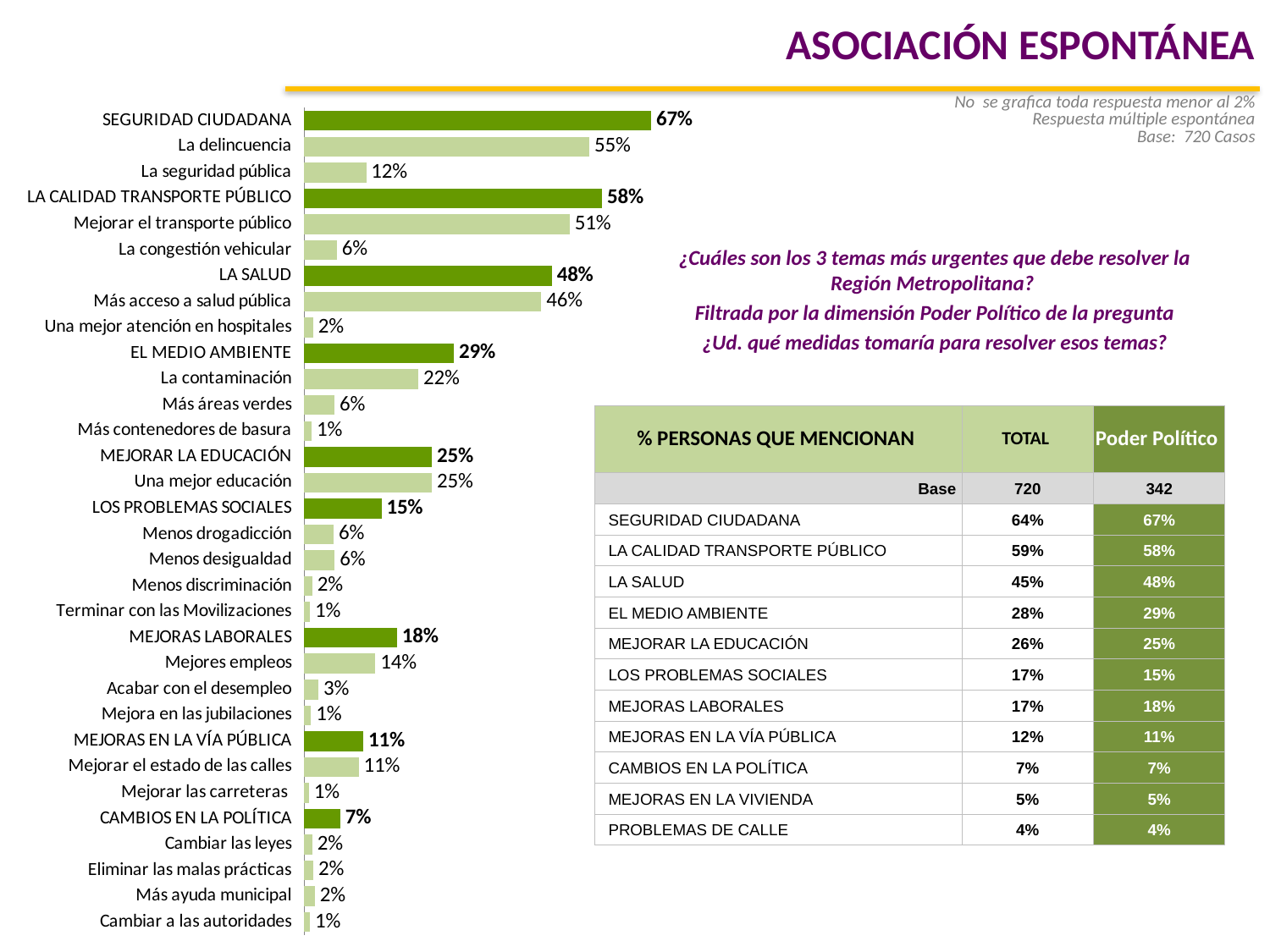
What kind of chart is shown on the slide? bar chart What is the difference between the values for LA CALIDAD TRANSPORTE PÚBLICO and LA SALUD in the bar chart? 10% What is the difference between the values for EL MEDIO AMBIENTE and La contaminación in the bar chart? 7% What is the value for Mejores empleos in the bar chart? 14% What is the value for Más acceso a salud pública in the bar chart? 46% What is the value for SEGURIDAD CIUDADANA in the bar chart? 67% What is the value for La delincuencia in the bar chart? 55% How many categories are plotted in the bar chart? 32 What is the value for CAMBIOS EN LA POLÍTICA in the bar chart? 7% Which is larger in the bar chart, La seguridad pública or La congestión vehicular? La seguridad pública Which is larger in the bar chart, MEJORAS LABORALES or LOS PROBLEMAS SOCIALES? MEJORAS LABORALES Which category has the highest value in the bar chart? SEGURIDAD CIUDADANA